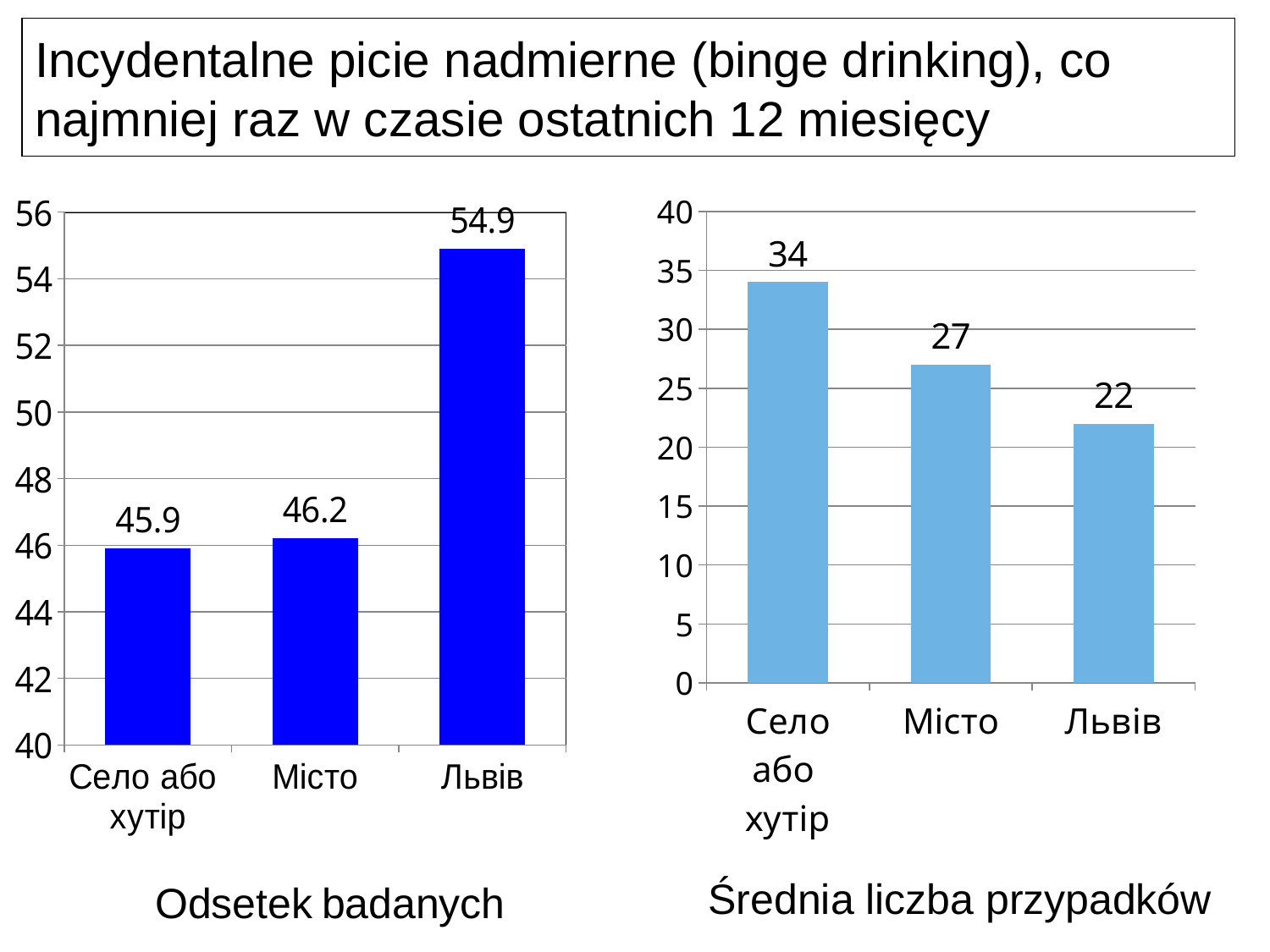
In the left chart (Odsetek badanych), which is larger: the value for Львів or the value for Село або хутір? Львів In the right chart (Średnia liczba przypadków), which category has the lowest value? Львів In the left chart (Odsetek badanych), what is the difference between the values for Львів and Місто? 8.7 In the right chart (Średnia liczba przypadków), which category has the highest value? Село або хутір In the left chart (Odsetek badanych), which category has the highest value? Львів What kind of chart is the left chart (Odsetek badanych)? bar chart In the left chart (Odsetek badanych), what is the value for Село або хутір? 45.9 In the right chart (Średnia liczba przypadków), what is the value for Місто? 27 In the right chart (Średnia liczba przypadków), do the values rise or fall from left to right? fall In the left chart (Odsetek badanych), what is the value for Львів? 54.9 How many categories are shown in the right chart (Średnia liczba przypadków)? 3 In the right chart (Średnia liczba przypadków), what is the difference between the values for Село або хутір and Львів? 12